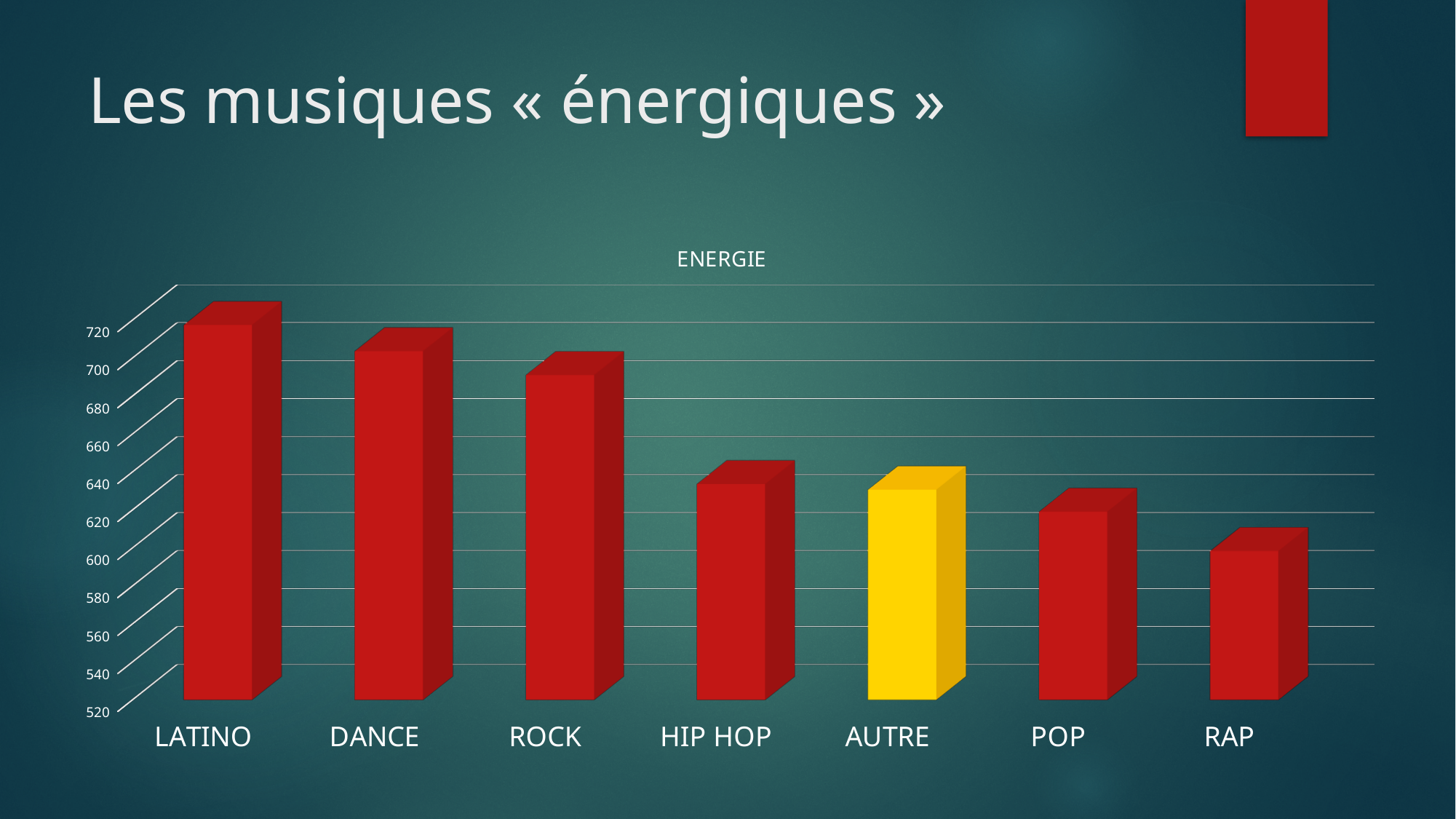
Which category has the highest ENERGIE value? LATINO Which category has the lowest ENERGIE value? RAP Which has a higher ENERGIE value, ROCK or HIP HOP? ROCK How many music categories are plotted on the chart? 7 What kind of chart is shown on the slide? bar chart Is the value for HIP HOP greater or less than 660? less Is the value for RAP greater or less than 580? greater Is the value for POP greater or less than 640? less Which has a higher ENERGIE value, DANCE or POP? DANCE Do the values rise or fall from left to right across the categories? fall Which category's bar is coloured yellow instead of red? AUTRE